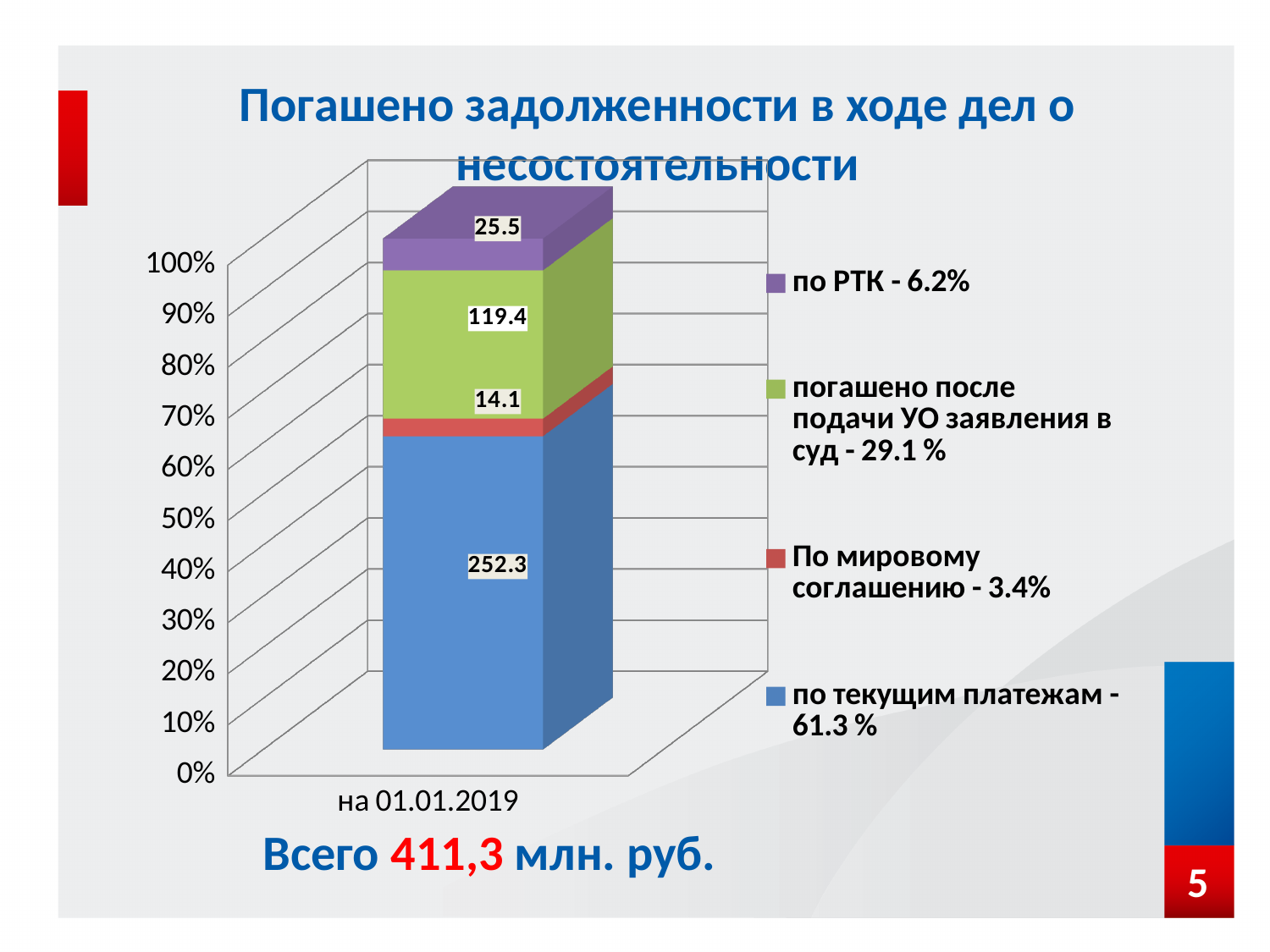
What is the value labelled for the 'погашено после подачи УО заявления в суд' segment? 119.4 What is the value labelled for the 'По мировому соглашению' segment? 14.1 What is the value labelled for the 'по РТК' segment of the bar? 25.5 Which series has the largest value in the stacked bar? по текущим платежам What percentage share does the legend give for 'по текущим платежам'? 61.3 % Which is larger: the 'по РТК' value or the 'По мировому соглашению' value? по РТК What is the value labelled for the 'по текущим платежам' segment of the bar? 252.3 What is the difference between the 'по текущим платежам' value and the 'погашено после подачи УО заявления в суд' value? 132.9 How many series does the legend list? 4 What is the total of the stacked bar for 'на 01.01.2019'? 411.3 What kind of chart is shown on the slide? stacked bar chart Which series has the smallest value in the stacked bar? По мировому соглашению